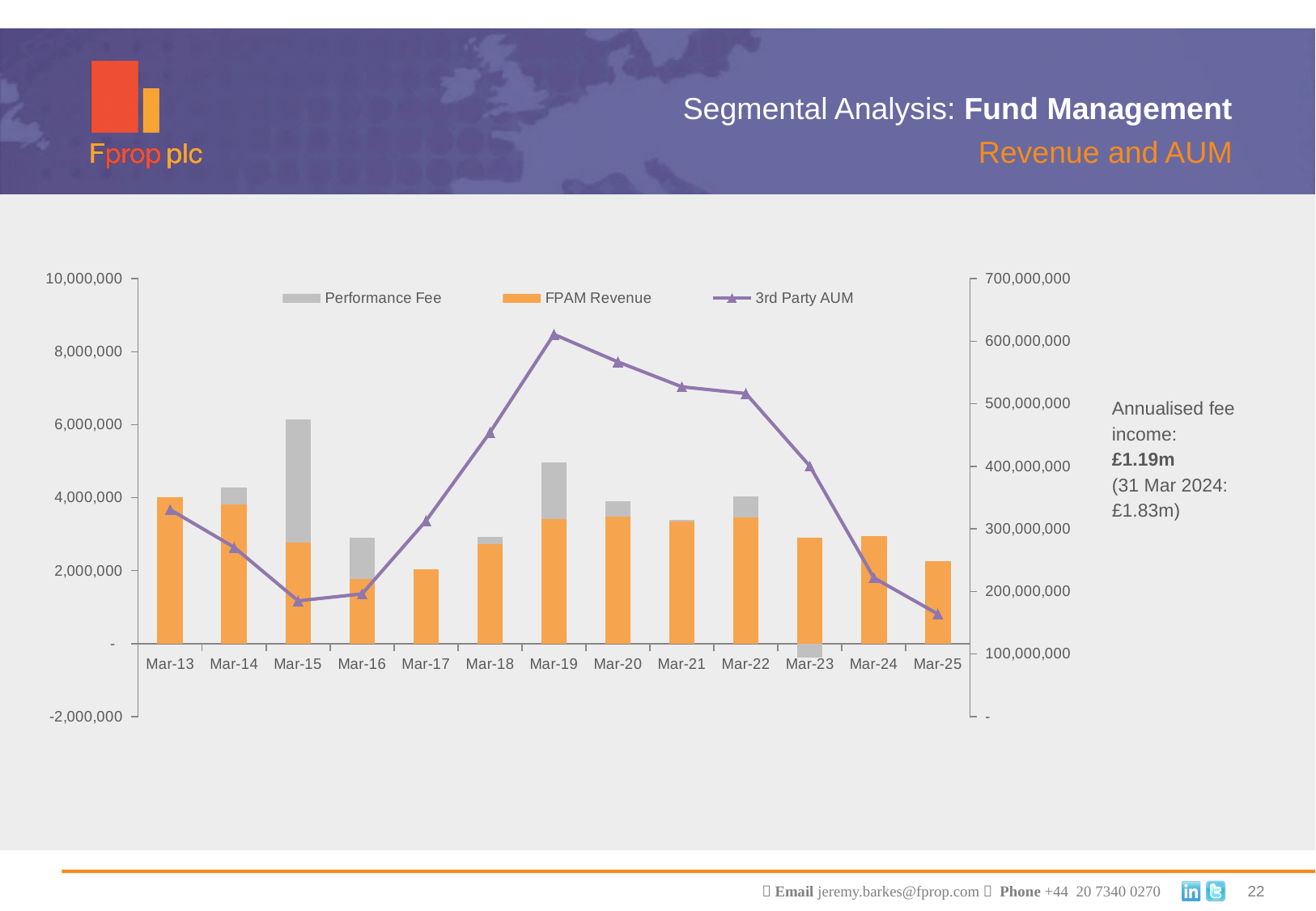
Which colour represents the Performance Fee series in the chart? Grey In which period is FPAM Revenue the highest? Mar-13 In which period is the Performance Fee bar the largest? Mar-15 Is the 3rd Party AUM value for Mar-13 greater or less than 300,000,000? greater Does 3rd Party AUM rise or fall from Mar-19 to Mar-25? fall How many series does the chart legend list? 3 In which period does 3rd Party AUM reach its highest value? Mar-19 What kind of chart is shown on the slide? Combined bar and line chart Is the FPAM Revenue value for Mar-17 greater or less than 4,000,000? less How many time periods are shown on the x axis of the chart? 13 Which is larger, 3rd Party AUM in Mar-19 or in Mar-20? Mar-19 Is the 3rd Party AUM value for Mar-19 greater or less than 500,000,000? greater